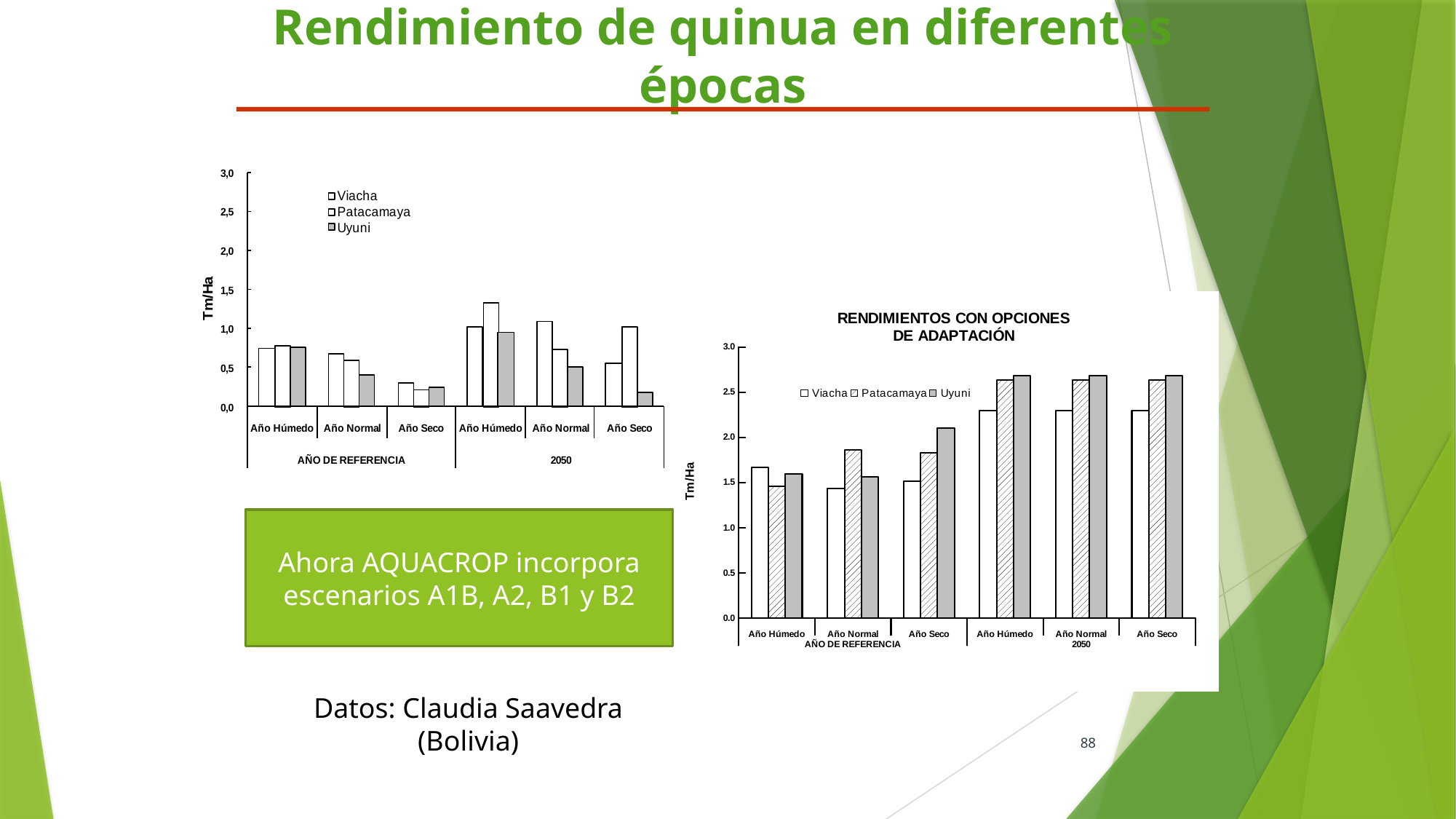
In the chart on the left of the slide, which location has the highest bar overall, and in which category? Patacamaya, Año Húmedo (2050) In the chart on the left of the slide, how many series does the legend list? 3 In the RENDIMIENTOS CON OPCIONES DE ADAPTACIÓN chart, is the value for Uyuni in Año Húmedo under 2050 greater or less than 2.5? greater What is the title of the chart on the right of the slide? RENDIMIENTOS CON OPCIONES DE ADAPTACIÓN In the RENDIMIENTOS CON OPCIONES DE ADAPTACIÓN chart, which is larger in Año Normal under AÑO DE REFERENCIA: Viacha or Patacamaya? Patacamaya In the RENDIMIENTOS CON OPCIONES DE ADAPTACIÓN chart, is the value for Patacamaya in Año Normal under AÑO DE REFERENCIA greater or less than 1.5? greater What kind of chart is the chart on the left of the slide? bar chart In the chart on the left of the slide, is the value for Patacamaya in Año Húmedo under 2050 greater or less than 1,0? greater In the chart on the left of the slide, do Viacha's values rise or fall from Año Húmedo to Año Seco under AÑO DE REFERENCIA? fall In the RENDIMIENTOS CON OPCIONES DE ADAPTACIÓN chart, how many category groups are shown on the x axis? 6 In the chart on the left of the slide, which location has the highest value in Año Normal under 2050? Viacha